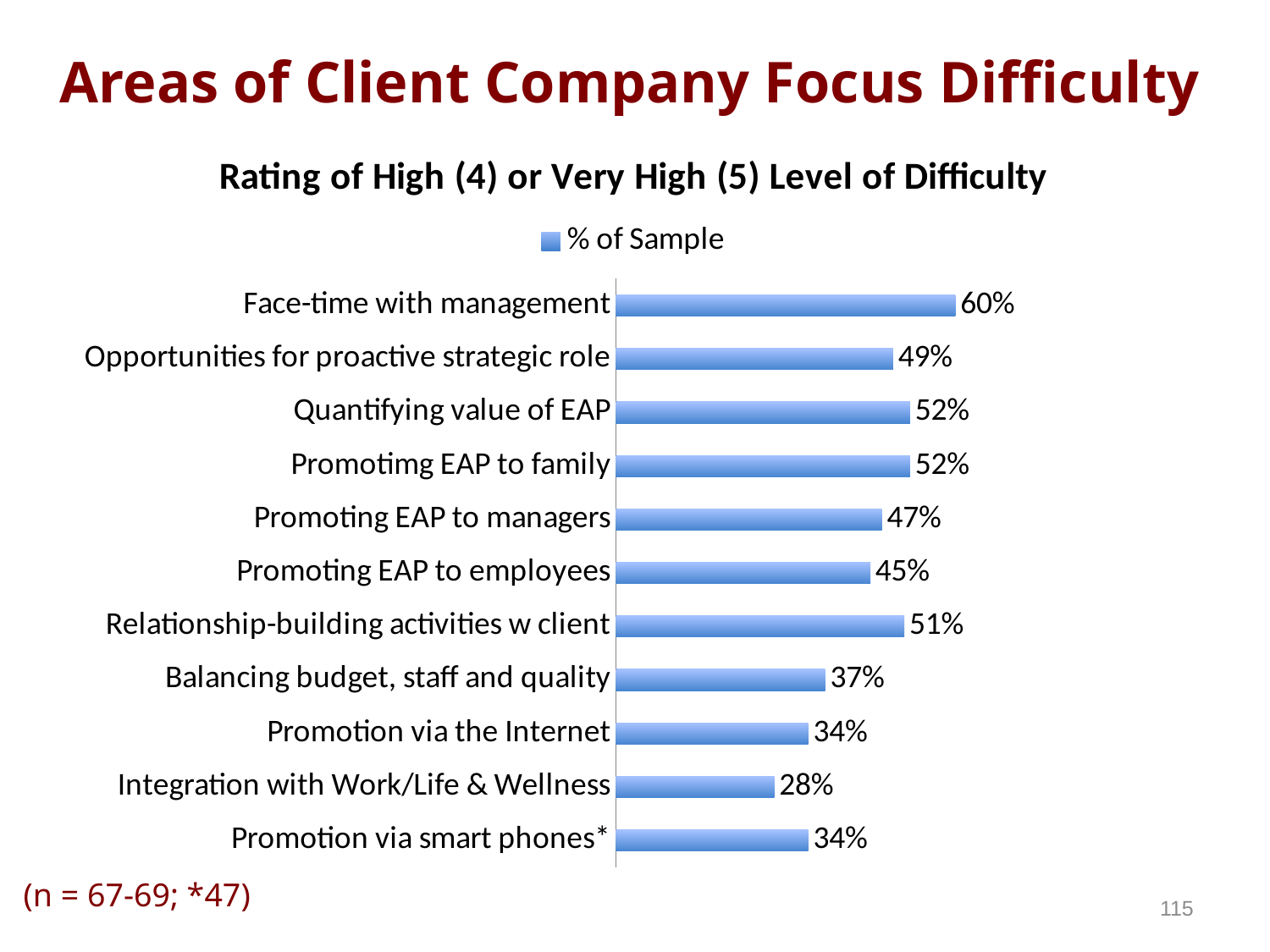
How many categories are shown in the chart? 11 What is the value for Face-time with management? 60% What is the chart's title? Rating of High (4) or Very High (5) Level of Difficulty What is the value for Balancing budget, staff and quality? 37% What is the difference between Face-time with management and Promoting EAP to employees? 15% Which is larger, Opportunities for proactive strategic role or Promoting EAP to managers? Opportunities for proactive strategic role Which category has the lowest value? Integration with Work/Life & Wellness What is the legend entry for the series? % of Sample Which category has the highest value? Face-time with management What is the value for Integration with Work/Life & Wellness? 28% What kind of chart is shown? bar chart How many series does the legend list? 1